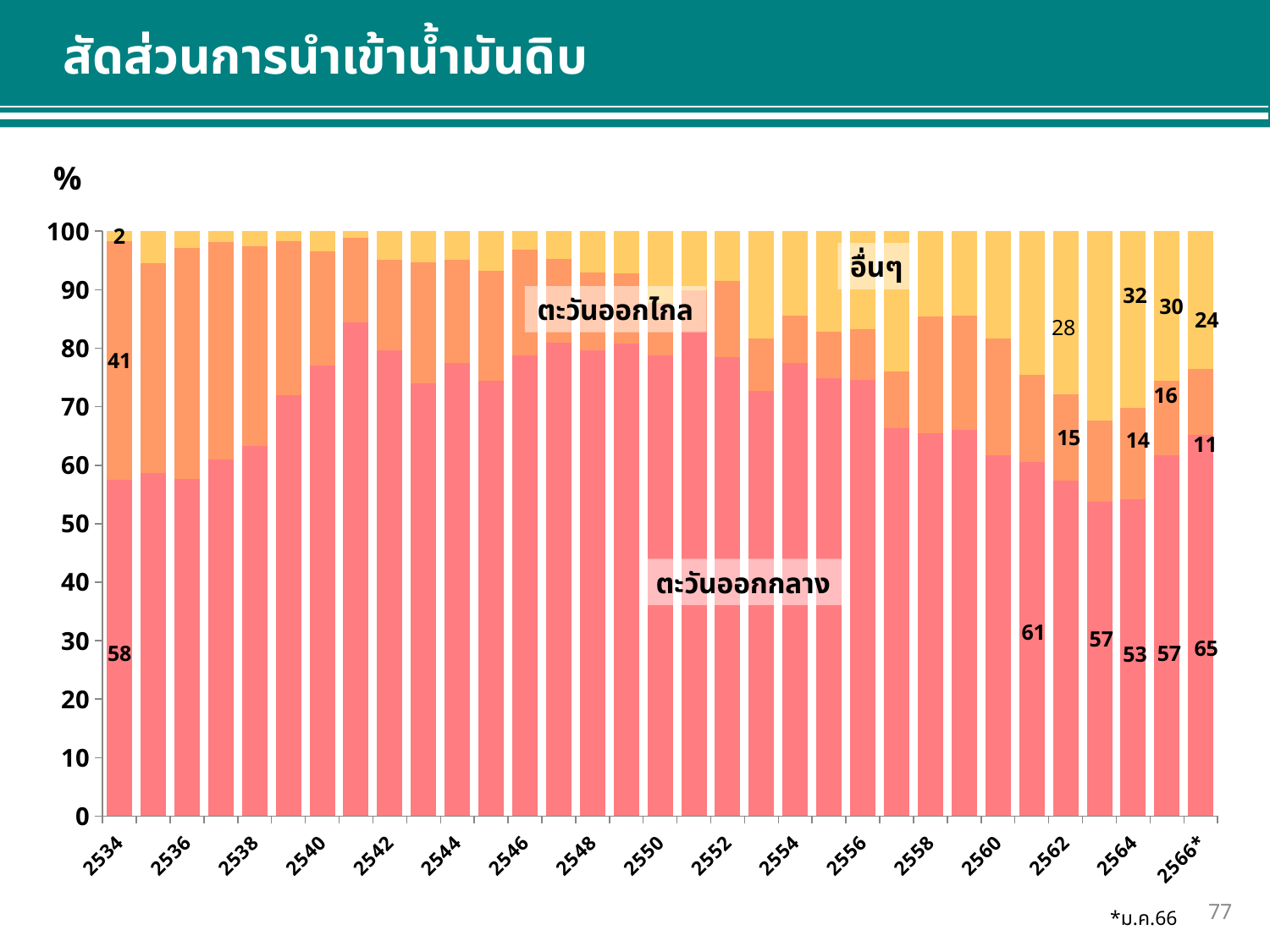
What is the share of ตะวันออกกลาง (Middle East) in 2566*? 65 Which is larger in 2566*: the share of ตะวันออกไกล or the share of อื่นๆ? อื่นๆ Is the ตะวันออกกลาง share in 2541 greater or less than 80? greater What is the share of ตะวันออกไกล (Far East) in 2534? 41 What is the share of ตะวันออกไกล (Far East) in 2566*? 11 What is the share of ตะวันออกกลาง (Middle East) in 2534? 58 What type of chart is shown on the slide? stacked bar chart What is the difference between the ตะวันออกกลาง share in 2566* and in 2534? 7 What is the share of อื่นๆ (Others) in 2534? 2 What does the footnote say the asterisk on 2566* refers to? ม.ค.66 How many regional series are stacked in each bar? 3 What is the share of อื่นๆ (Others) in 2566*? 24